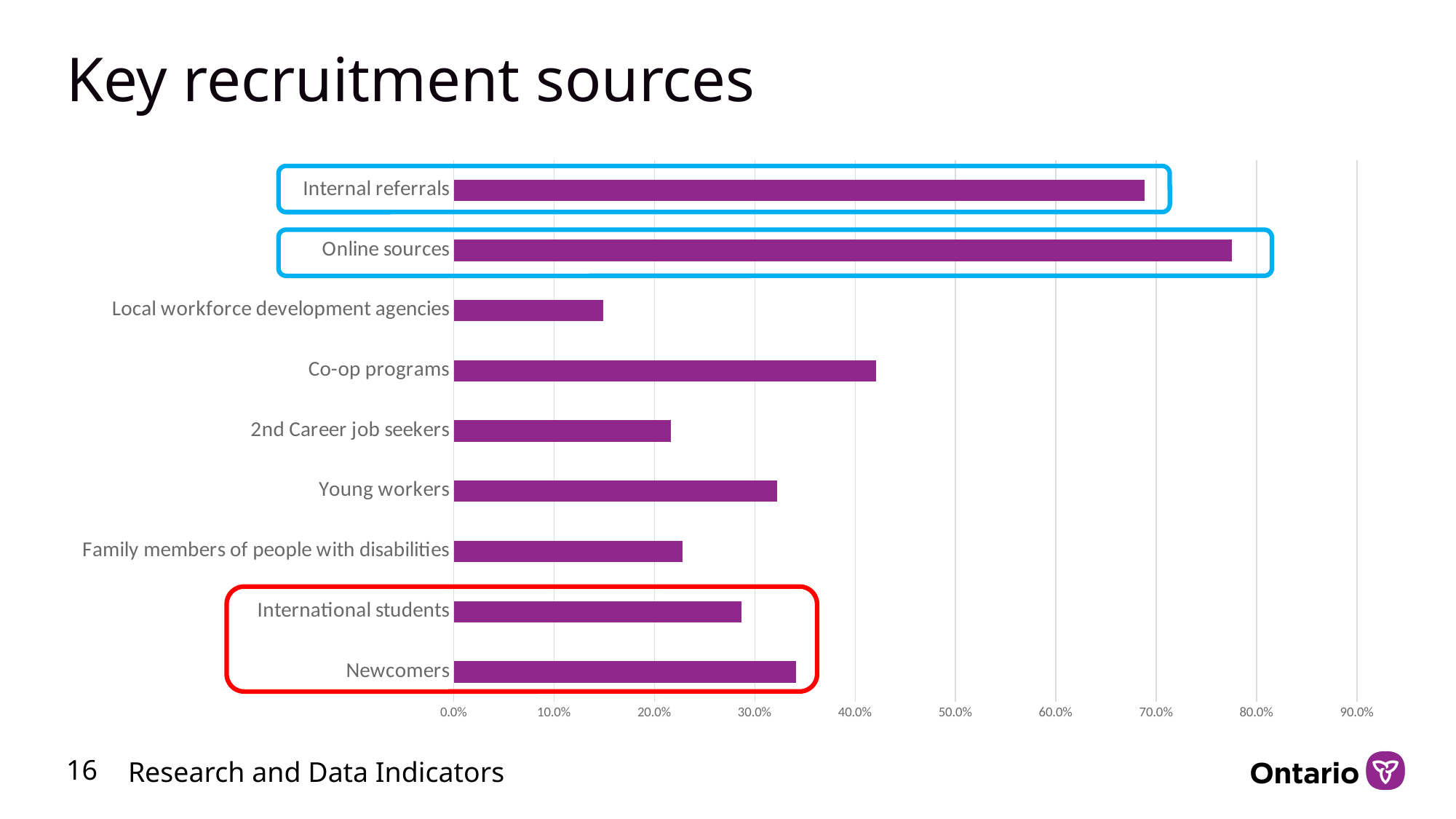
Which is larger, the value for Co-op programs or the value for Young workers? Co-op programs How many recruitment sources are plotted in the chart? 9 Which two recruitment sources are outlined with a red box on the chart? International students and Newcomers Which recruitment source has the lowest value? Local workforce development agencies Is the value for Newcomers greater or less than 30.0%? greater Is the value for Online sources greater or less than 70.0%? greater Is the value for Local workforce development agencies greater or less than 20.0%? less Which is larger, the value for International students or the value for Newcomers? Newcomers Which recruitment source has the highest value? Online sources What kind of chart is shown on the slide? bar chart